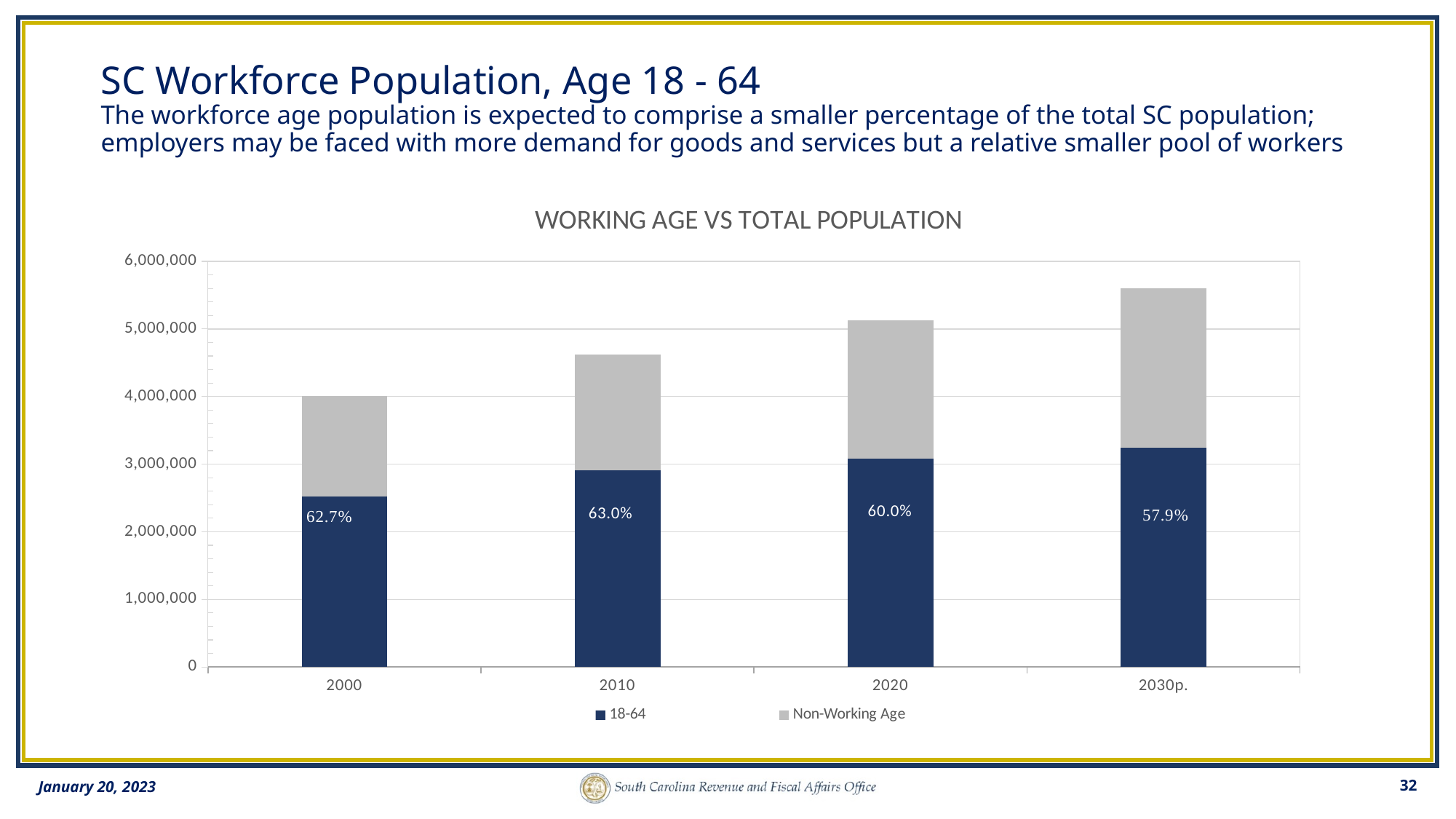
What percentage label is shown on the 18-64 segment for 2000? 62.7% How many years are shown on the x axis? 4 Which year has the lowest 18-64 percentage label? 2030p. What percentage label is shown on the 18-64 segment for 2020? 60.0% How many series does the legend list? 2 Which year has the taller total stacked bar, 2000 or 2030p.? 2030p. What kind of chart is shown on the slide? Stacked bar chart Is the total stacked bar for 2030p. greater or less than 5,000,000? greater What is the difference between the 18-64 percentage labels for 2010 and 2030p.? 5.1 percentage points Which year has the highest 18-64 percentage label? 2010 What percentage label is shown on the 18-64 segment for 2030p.? 57.9% Is the total stacked bar for 2000 greater or less than 5,000,000? less